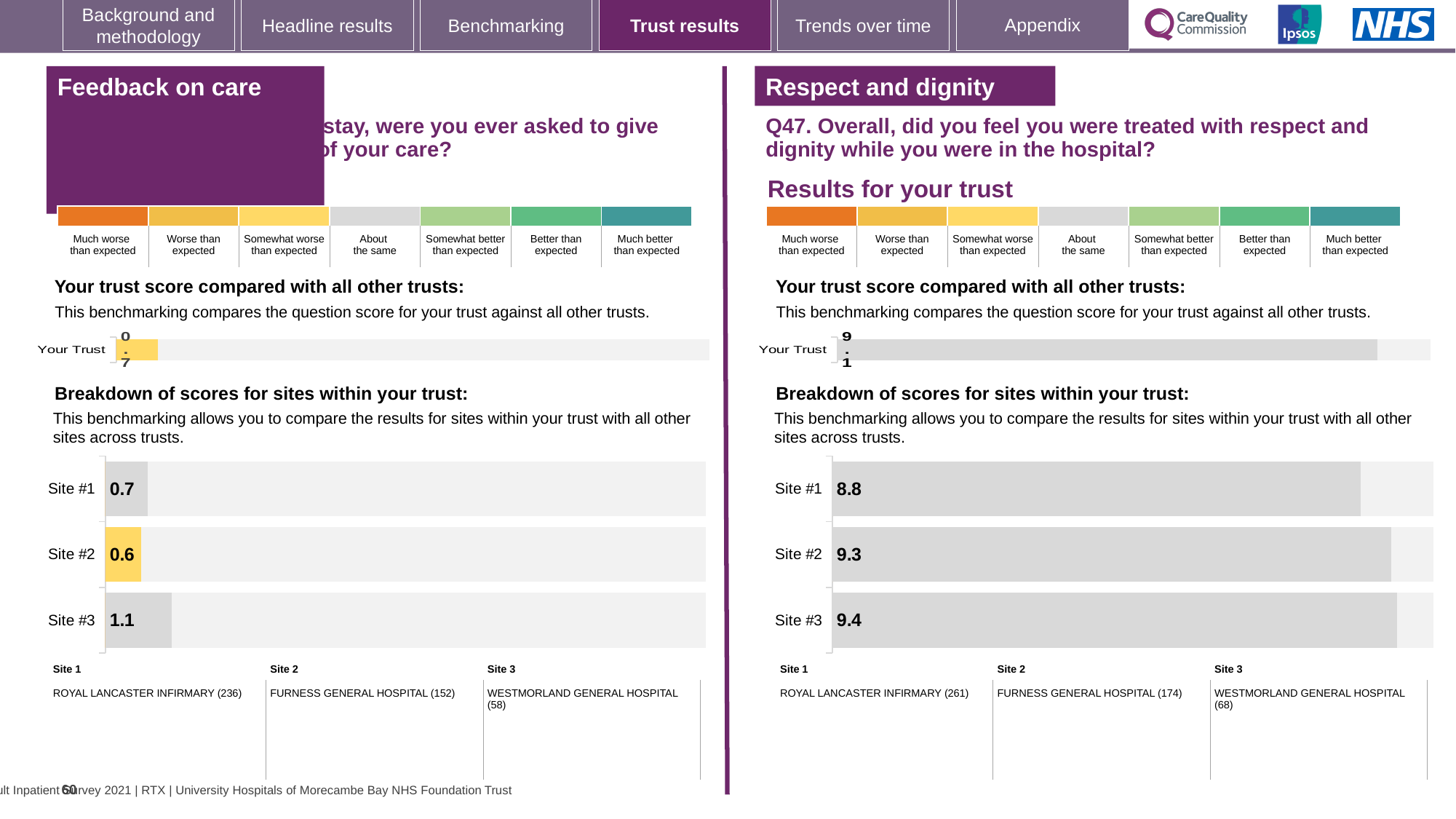
In the 'Breakdown of scores for sites within your trust' chart on the right (Respect and dignity) panel, what is the score for Site #2? 9.3 What kind of chart is used for the 'Breakdown of scores for sites within your trust' on the right (Respect and dignity) panel? Bar chart In the 'Breakdown of scores for sites within your trust' chart on the left (Feedback on care) panel, which site has the lowest score? Site #2 In the 'Your trust score compared with all other trusts' chart on the left (Feedback on care) panel, what is the score for Your Trust? 0.7 In the site breakdown chart on the left (Feedback on care) panel, what is the difference between the scores for Site #3 and Site #2? 0.5 In the site breakdown chart on the right (Respect and dignity) panel, which has the larger score, Site #1 or Site #3? Site #3 In the 'Breakdown of scores for sites within your trust' chart on the left (Feedback on care) panel, which site has the highest score? Site #3 In the 'Breakdown of scores for sites within your trust' chart on the right (Respect and dignity) panel, which site has the lowest score? Site #1 In the site breakdown chart on the right (Respect and dignity) panel, what is the difference between the scores for Site #3 and Site #1? 0.6 In the 'Breakdown of scores for sites within your trust' chart on the left (Feedback on care) panel, what is the score for Site #1? 0.7 In the 'Your trust score compared with all other trusts' chart on the right (Respect and dignity) panel, what is the score for Your Trust? 9.1 How many sites are shown in the 'Breakdown of scores for sites within your trust' chart on the left (Feedback on care) panel? 3